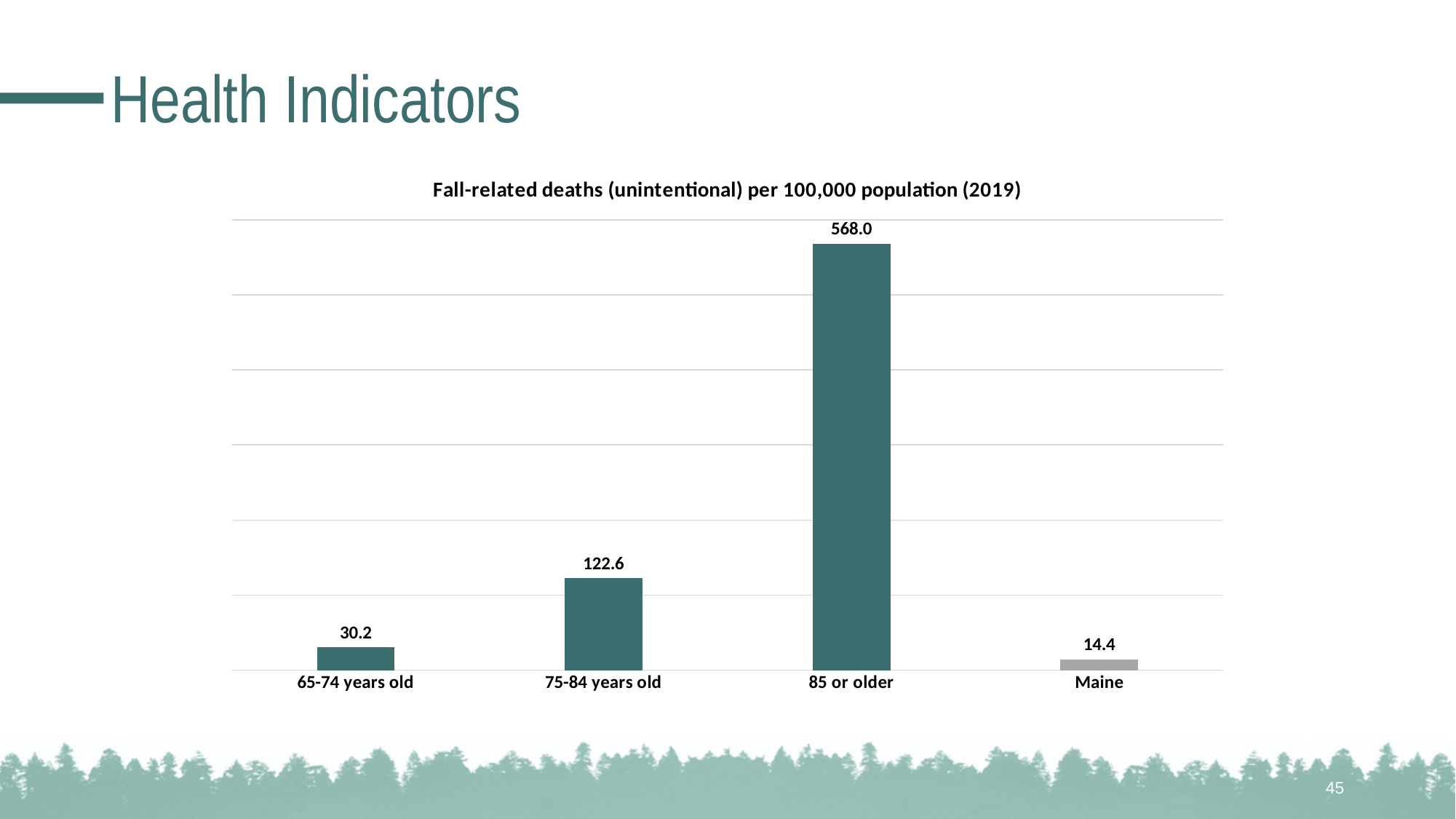
What is the title of the chart? Fall-related deaths (unintentional) per 100,000 population (2019) What is the value for 65-74 years old? 30.2 Which category has the highest value? 85 or older What is the value for 75-84 years old? 122.6 What is the value for Maine? 14.4 What kind of chart is shown on the slide? Bar chart Which category has the lowest value? Maine What is the difference between the values for 65-74 years old and Maine? 15.8 What is the value for 85 or older? 568.0 Which is larger, the value for 75-84 years old or the value for 65-74 years old? 75-84 years old How many categories are shown on the chart? 4 What is the difference between the values for 85 or older and 75-84 years old? 445.4